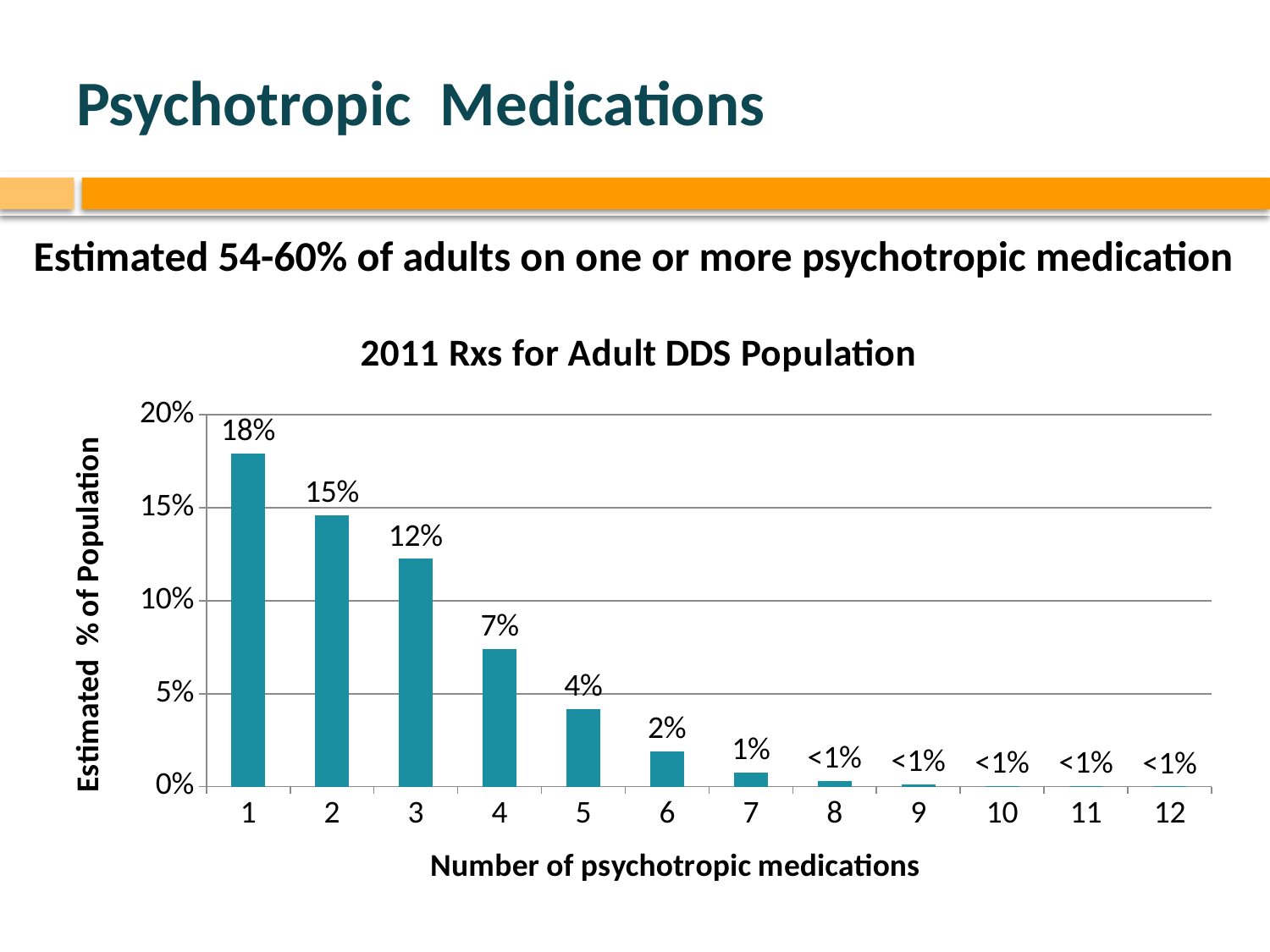
What is the difference between the percentages for 3 and 4 psychotropic medications? 5% Which number of psychotropic medications has the highest estimated percentage of the population? 1 Is the value for 2 psychotropic medications greater or less than 10%? greater What is the difference between the percentages for 1 and 2 psychotropic medications? 3% What is the data label shown for 8 psychotropic medications? <1% What is the estimated percentage of the population on 1 psychotropic medication? 18% Do the values rise or fall as the number of psychotropic medications increases? Fall What is the estimated percentage of the population on 3 psychotropic medications? 12% What is the estimated percentage of the population on 5 psychotropic medications? 4% How many categories are shown on the x axis? 12 What kind of chart is shown on the slide? Bar chart Which is larger, the percentage for 4 medications or the percentage for 6 medications? 4 medications